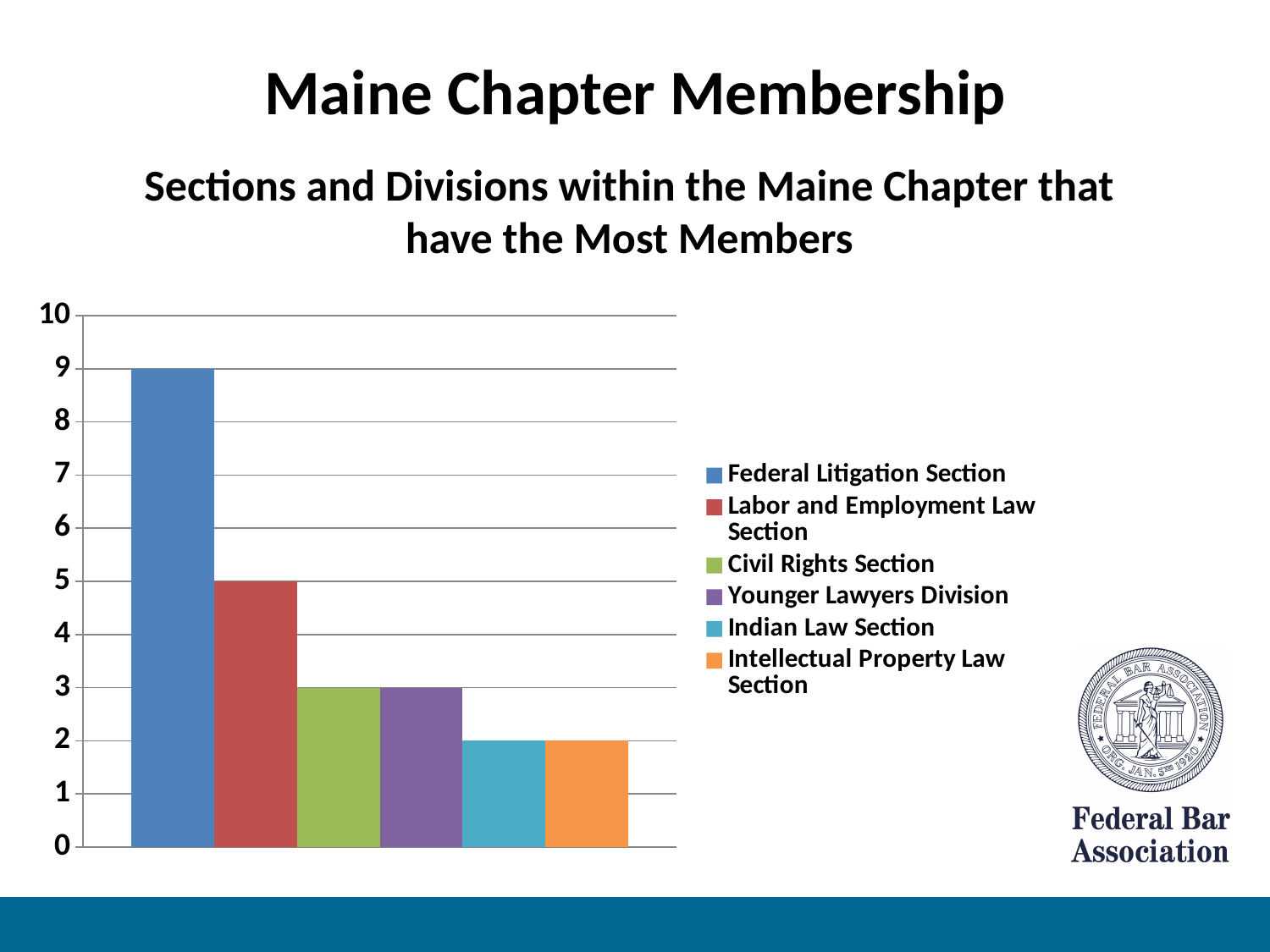
Which section or division has the most members? Federal Litigation Section What is the value for the Indian Law Section? 2 Which is larger, the Labor and Employment Law Section or the Younger Lawyers Division? Labor and Employment Law Section What is the difference between the Federal Litigation Section and the Labor and Employment Law Section? 4 What is the value for the Labor and Employment Law Section? 5 How many bars are plotted in the chart? 6 How many series does the legend list? 6 What is the subtitle above the chart? Sections and Divisions within the Maine Chapter that have the Most Members How many members does the Federal Litigation Section have? 9 What is the value for the Civil Rights Section? 3 Is the value for the Federal Litigation Section greater or less than 8? greater What kind of chart is shown on the slide? Bar chart